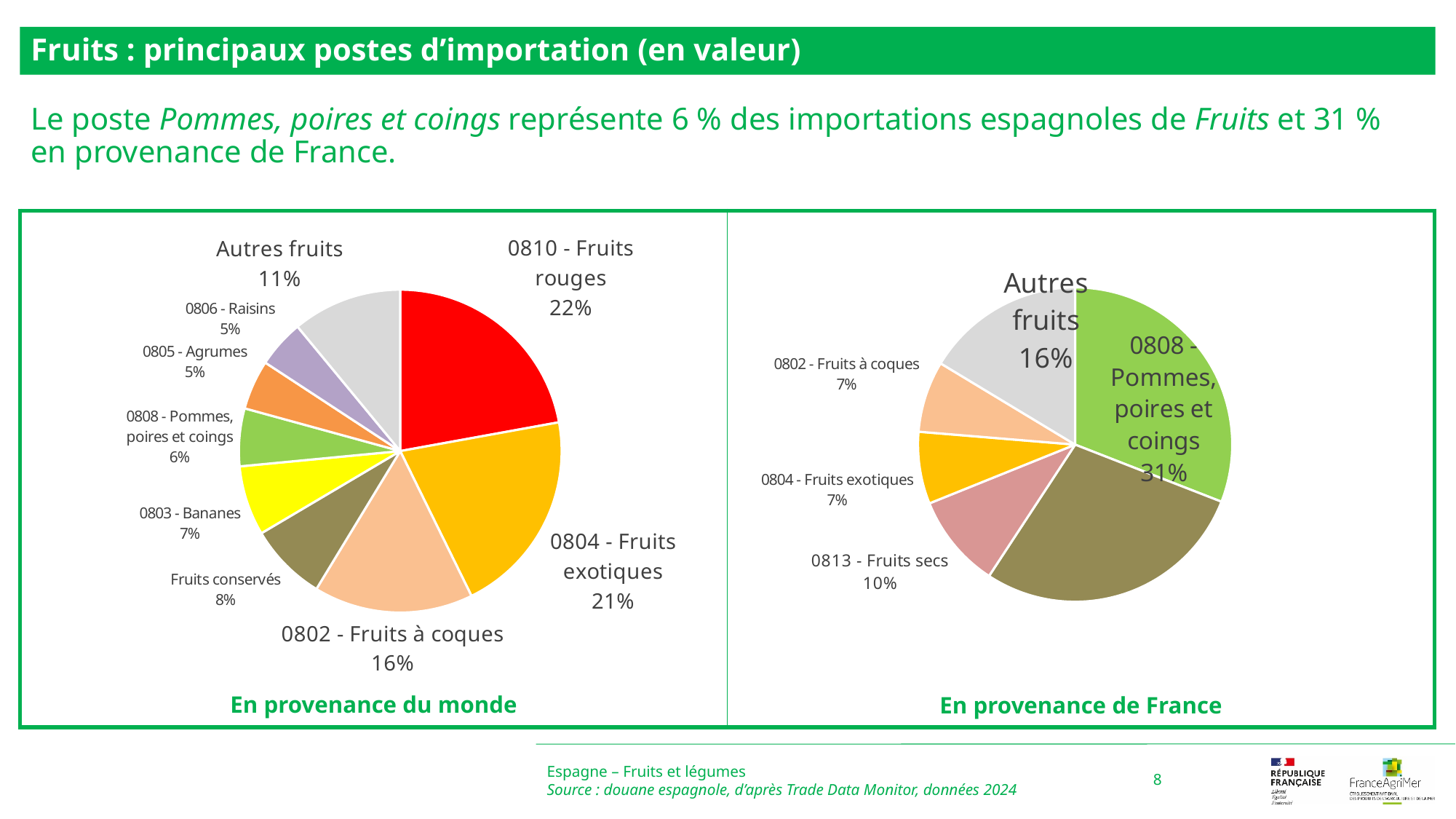
In the 'En provenance du monde' chart, what share does 0810 - Fruits rouges represent? 22% In the 'En provenance du monde' chart, which is larger: Fruits conservés or 0808 - Pommes, poires et coings? Fruits conservés In the 'En provenance de France' chart, what is the difference in percentage points between 0808 - Pommes, poires et coings and 0813 - Fruits secs? 21 In the 'En provenance de France' chart, what share does 0813 - Fruits secs represent? 10% In the 'En provenance du monde' chart, what share does 0802 - Fruits à coques represent? 16% How many slices does the 'En provenance du monde' pie chart have? 9 In the 'En provenance du monde' chart, what is the difference in percentage points between 0804 - Fruits exotiques and 0803 - Bananes? 14 What type of chart is used on the slide? Pie chart What is the title of the slide? Fruits : principaux postes d'importation (en valeur) In the 'En provenance du monde' chart, which category has the largest slice? 0810 - Fruits rouges